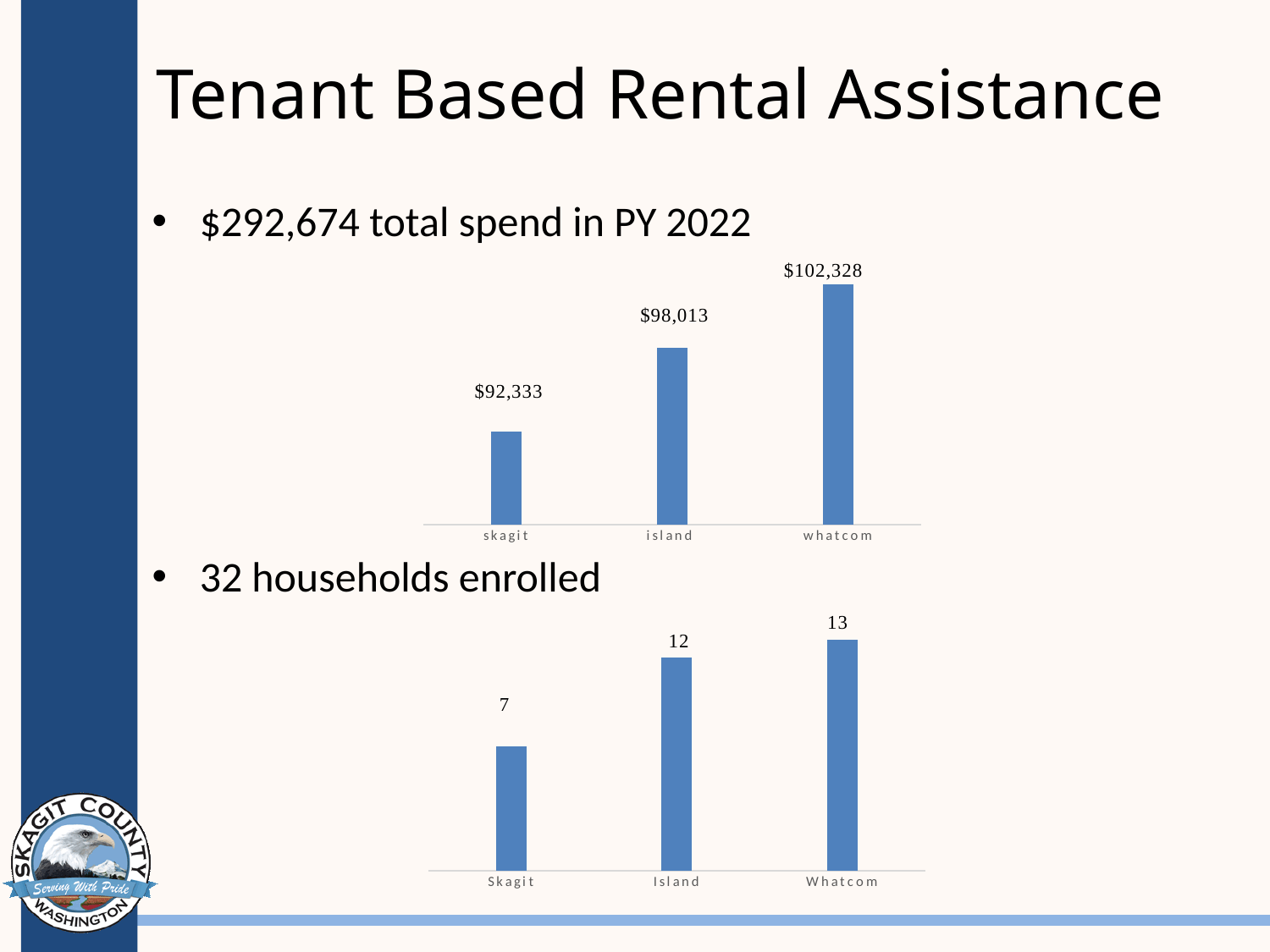
In the upper chart (total spend), what is the value for island? $98,013 In the lower chart (households enrolled), do the values rise or fall from Skagit to Whatcom? rise In the upper chart (total spend), how many categories are shown? 3 In the upper chart (total spend), what is the difference between whatcom and skagit? $9,995 In the upper chart (total spend), which category has the lowest value? skagit In the lower chart (households enrolled), what is the value for Island? 12 In the upper chart (total spend), what is the value for skagit? $92,333 What kind of chart is the lower chart (households enrolled)? bar chart In the upper chart (total spend), which category has the highest value? whatcom In the lower chart (households enrolled), which category has the highest value? Whatcom In the lower chart (households enrolled), what is the difference between Island and Skagit? 5 In the lower chart (households enrolled), what is the value for Skagit? 7